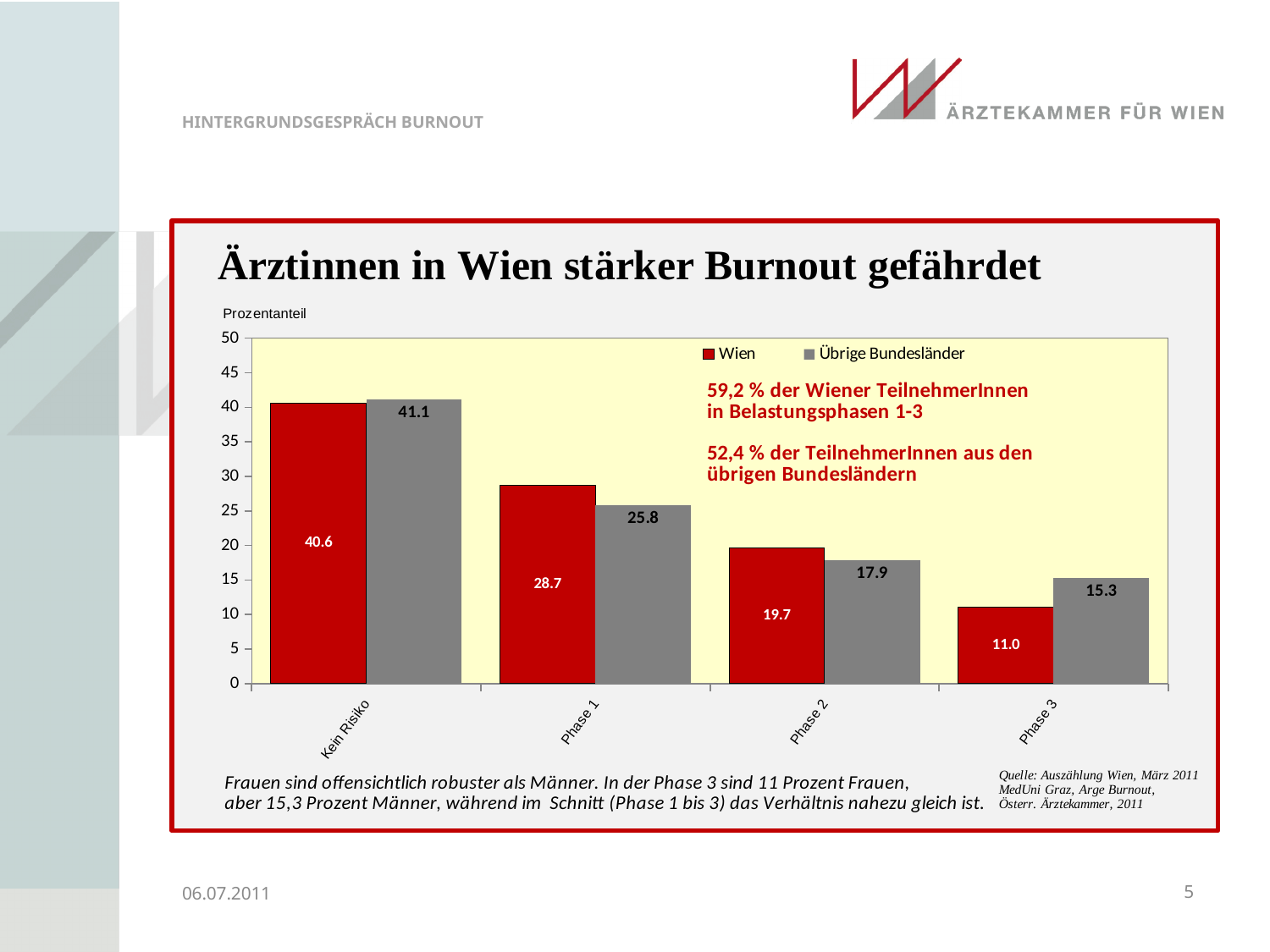
How many categories are shown on the x axis? 4 How many series does the legend list? 2 Which category has the highest value for Übrige Bundesländer? Kein Risiko What is the difference between Wien and Übrige Bundesländer in Phase 2? 1.8 Do the values for Wien rise or fall from Kein Risiko to Phase 3? Fall Which category has the lowest value for Wien? Phase 3 In Phase 3, which series has the larger value, Wien or Übrige Bundesländer? Übrige Bundesländer What kind of chart is shown on the slide? Bar chart What is the value for Übrige Bundesländer in Phase 1? 25.8 What is the value for Wien in the Kein Risiko category? 40.6 What is the value for Wien in Phase 3? 11.0 What is the title of the chart? Ärztinnen in Wien stärker Burnout gefährdet